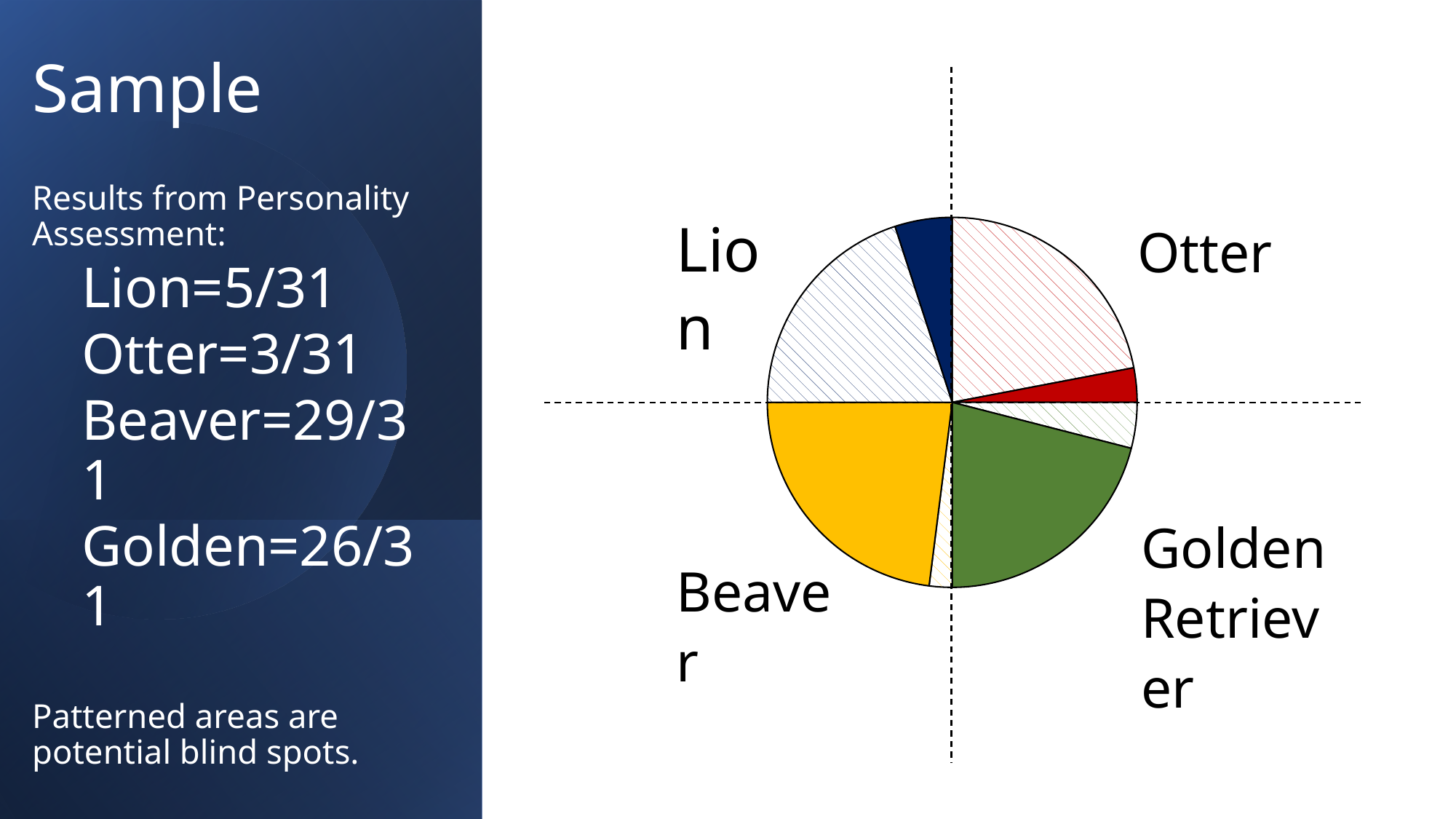
Which category label appears in the top-right quadrant of the pie chart? Otter What is the result printed for Lion? 5/31 Which is larger, the result for Beaver or the result for Golden? Beaver What is the result printed for Otter? 3/31 What is the difference between the Beaver result and the Golden result? 3/31 What kind of chart is shown on the slide? pie chart What is the result printed for Golden? 26/31 Which personality category has the lowest result? Otter What is the result printed for Beaver? 29/31 Which personality category has the highest result? Beaver How many personality categories are labelled around the pie chart? 4 According to the slide, what do the patterned areas of the chart represent? potential blind spots